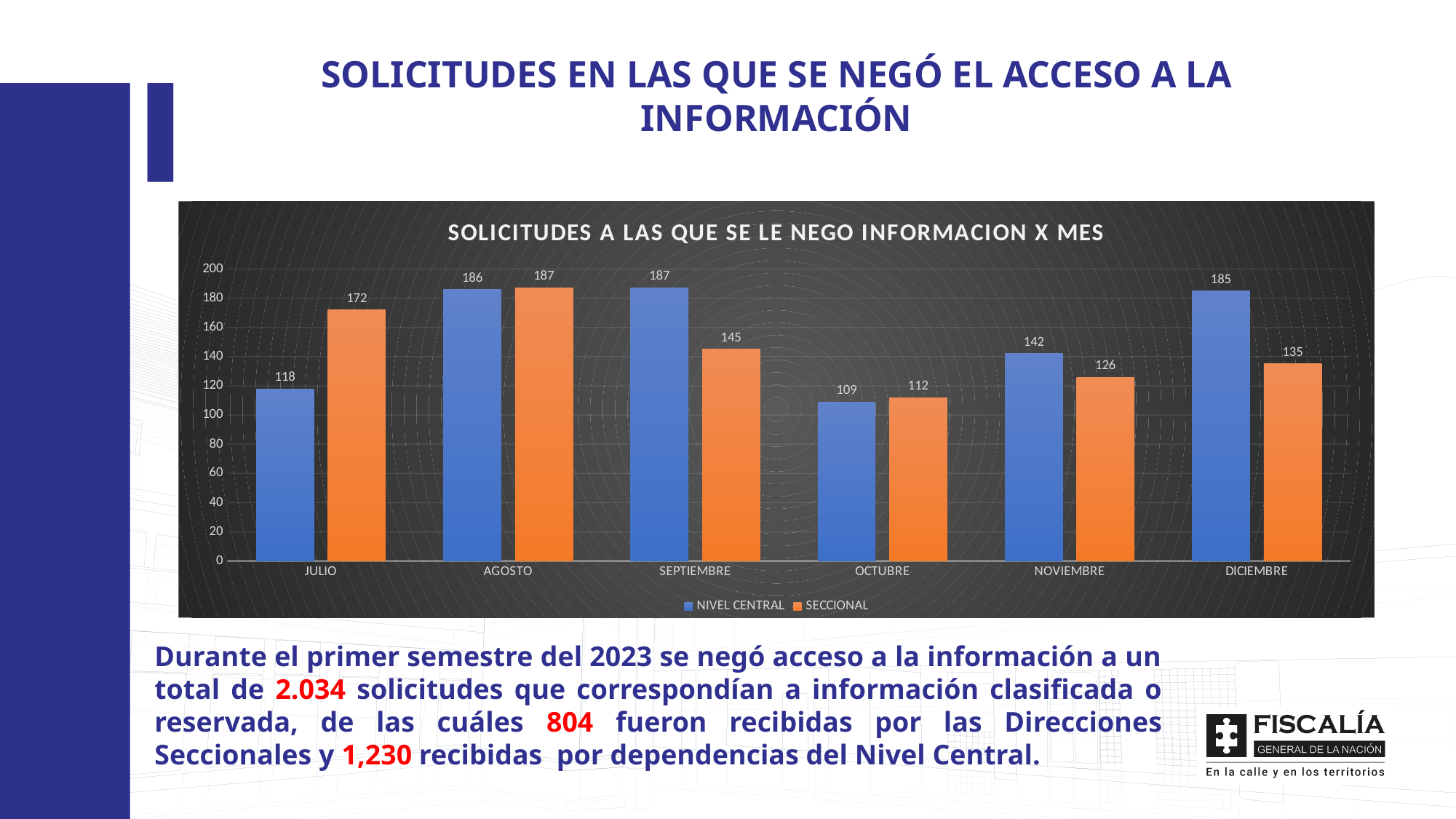
What is the difference between the NIVEL CENTRAL and SECCIONAL values in SEPTIEMBRE? 42 Is the SECCIONAL value for OCTUBRE greater or less than 120? less What is the value for NIVEL CENTRAL in DICIEMBRE? 185 How many months are shown on the x axis of the chart? 6 What is the value for NIVEL CENTRAL in JULIO? 118 How many series does the chart legend list? 2 What kind of chart is shown on the slide? bar chart In which month is the NIVEL CENTRAL value lowest? OCTUBRE In which month is the SECCIONAL value highest? AGOSTO What is the value for SECCIONAL in SEPTIEMBRE? 145 What is the difference between the SECCIONAL and NIVEL CENTRAL values in JULIO? 54 In NOVIEMBRE, which series has the larger value, NIVEL CENTRAL or SECCIONAL? NIVEL CENTRAL